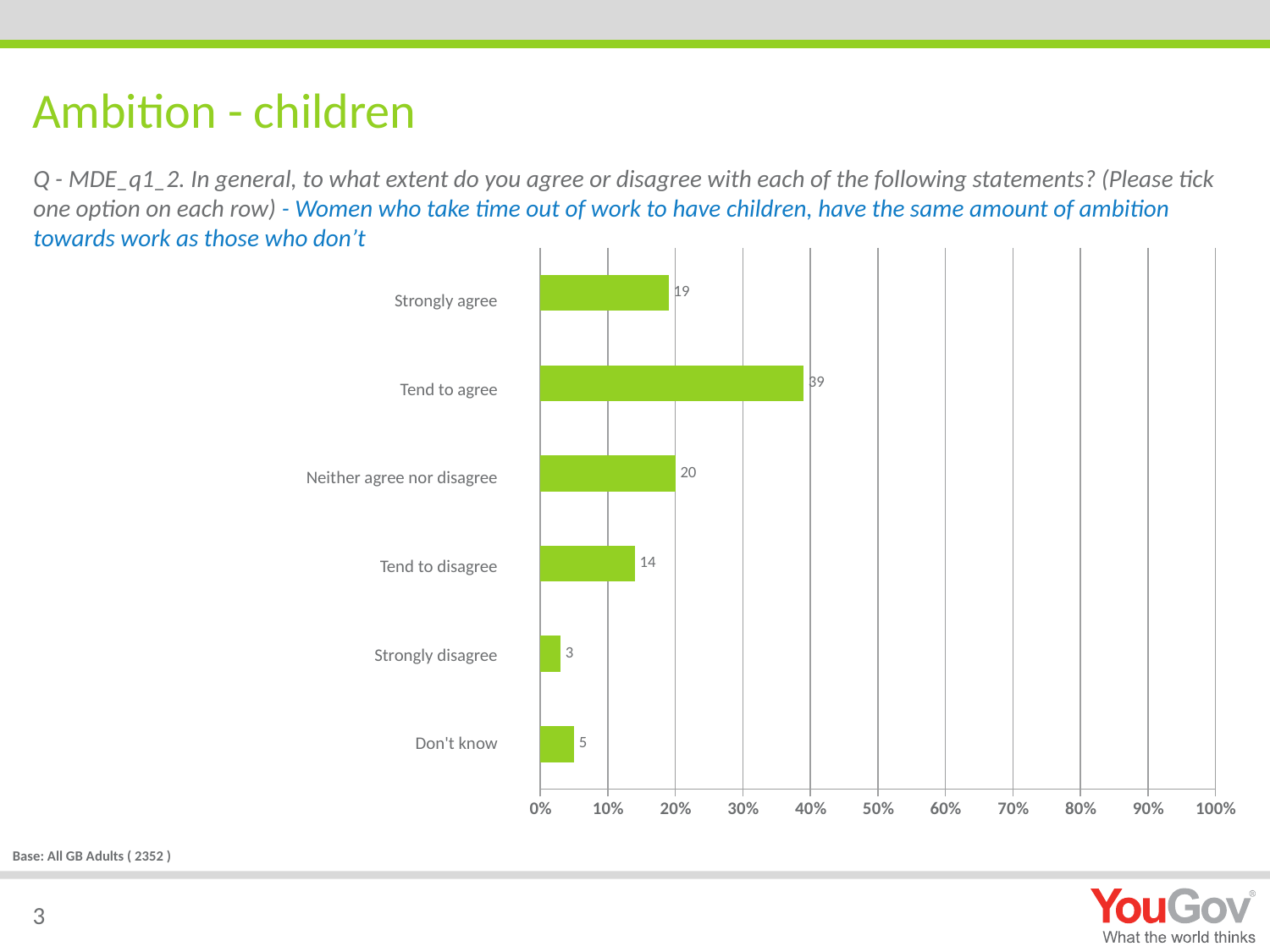
What is the difference between the values for "Tend to agree" and "Neither agree nor disagree"? 19 How many categories are shown on the chart? 6 What is the value for "Don't know"? 5 What is the title of the slide? Ambition - children Which category has the highest value? Tend to agree What is the value for "Strongly agree"? 19 What is the difference between the values for "Tend to disagree" and "Strongly disagree"? 11 What kind of chart is shown on the slide? Bar chart Is the value for "Tend to agree" greater or less than 30%? greater Which is larger, the value for "Strongly agree" or the value for "Tend to disagree"? Strongly agree What is the value for "Tend to agree"? 39 Which category has the lowest value? Strongly disagree